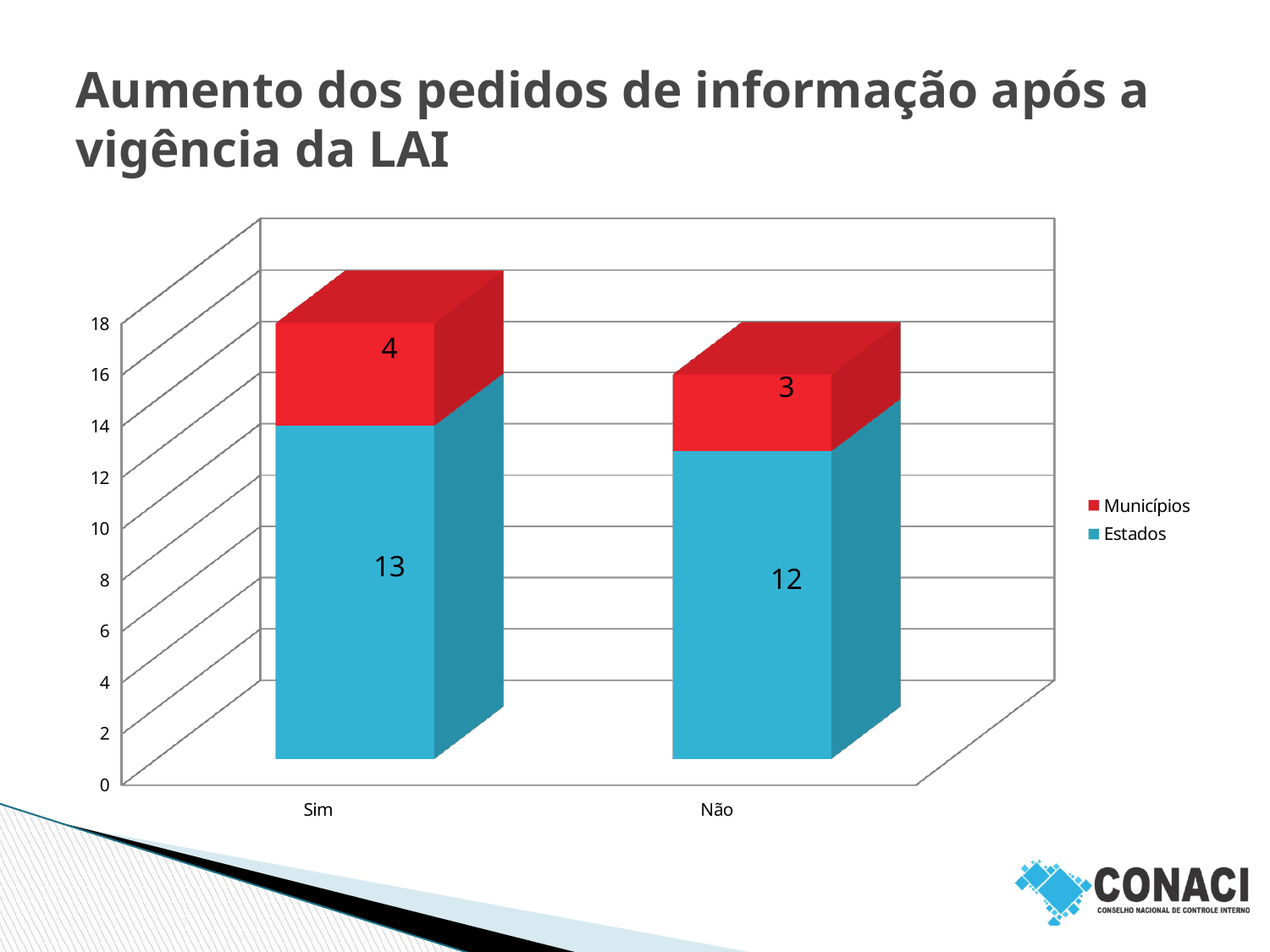
What is the value for Municípios in the Sim category? 4 What is the value for Municípios in the Não category? 3 How many series does the legend list? 2 What is the total of the stacked bar for Sim? 17 Which series is shown in red in the legend? Municípios What is the total of the stacked bar for Não? 15 What kind of chart is shown on the slide? Stacked bar chart How many categories are shown on the x axis? 2 What is the difference between the Estados values for Sim and Não? 1 What is the value for Estados in the Não category? 12 Which category has the higher Municípios value, Sim or Não? Sim What is the value for Estados in the Sim category? 13